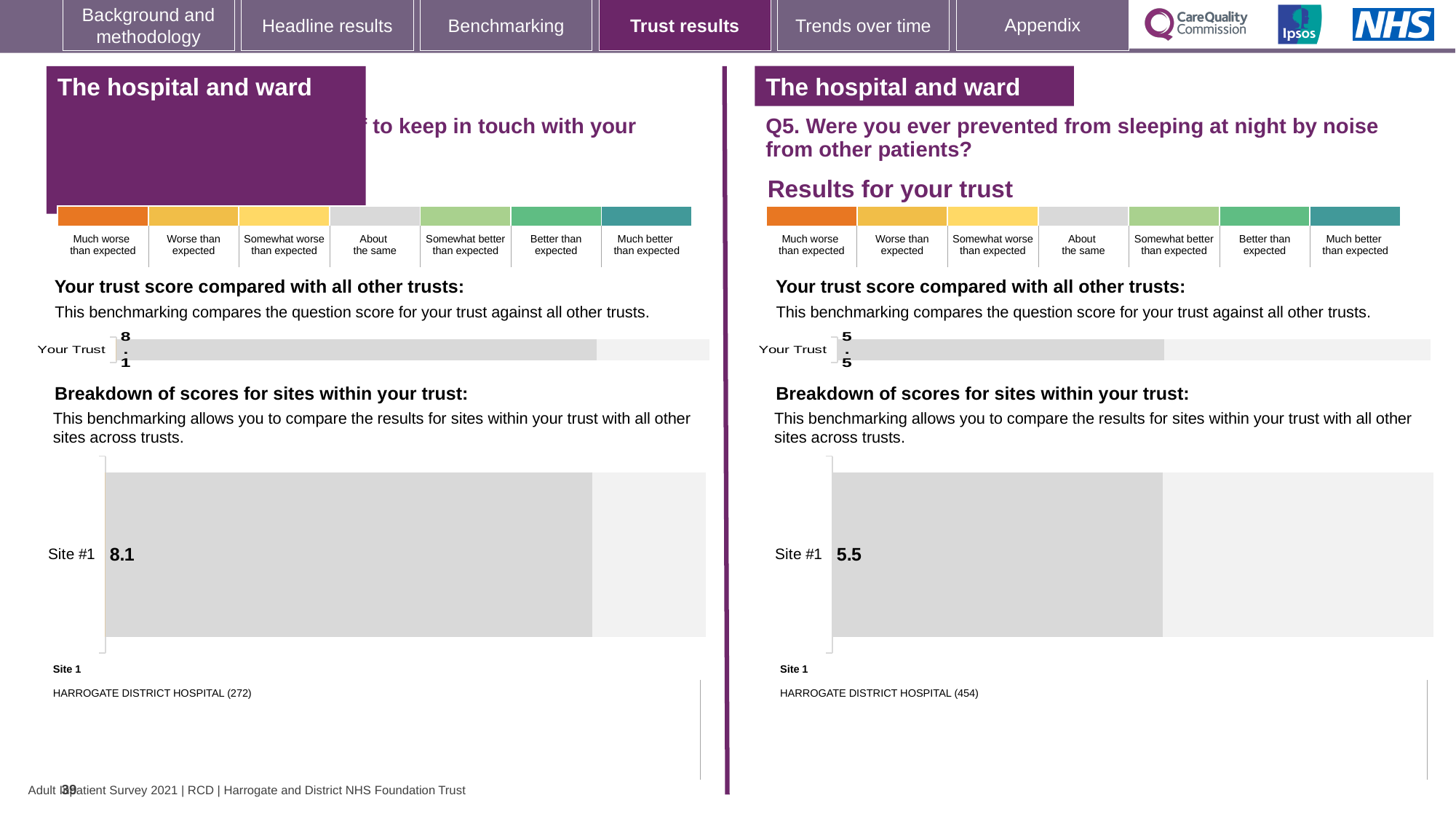
What is the difference between the Your Trust score on the left panel and the Your Trust score on the right panel (Q5)? 2.6 What kind of chart is used to show the Site #1 score on the left panel? Bar chart On the left panel's site breakdown chart, what is the score for Site #1? 8.1 On the right panel (Q5, prevented from sleeping at night by noise), what is the score shown for Your Trust? 5.5 On the right panel's site breakdown chart (Q5), what is the score for Site #1? 5.5 On the right panel (Q5), is the Site #1 score the same as the Your Trust score? Yes, both 5.5 Which site is listed as Site 1 on the right panel (Q5)? HARROGATE DISTRICT HOSPITAL (454) Which is larger: the Site #1 score on the left panel or the Site #1 score on the right panel (Q5)? Left panel (8.1) On the left panel, what is the score shown for Your Trust? 8.1 How many respondents are shown in brackets for Site 1 on the left panel? 272 How many sites are shown in the site breakdown chart on the right panel (Q5)? 1